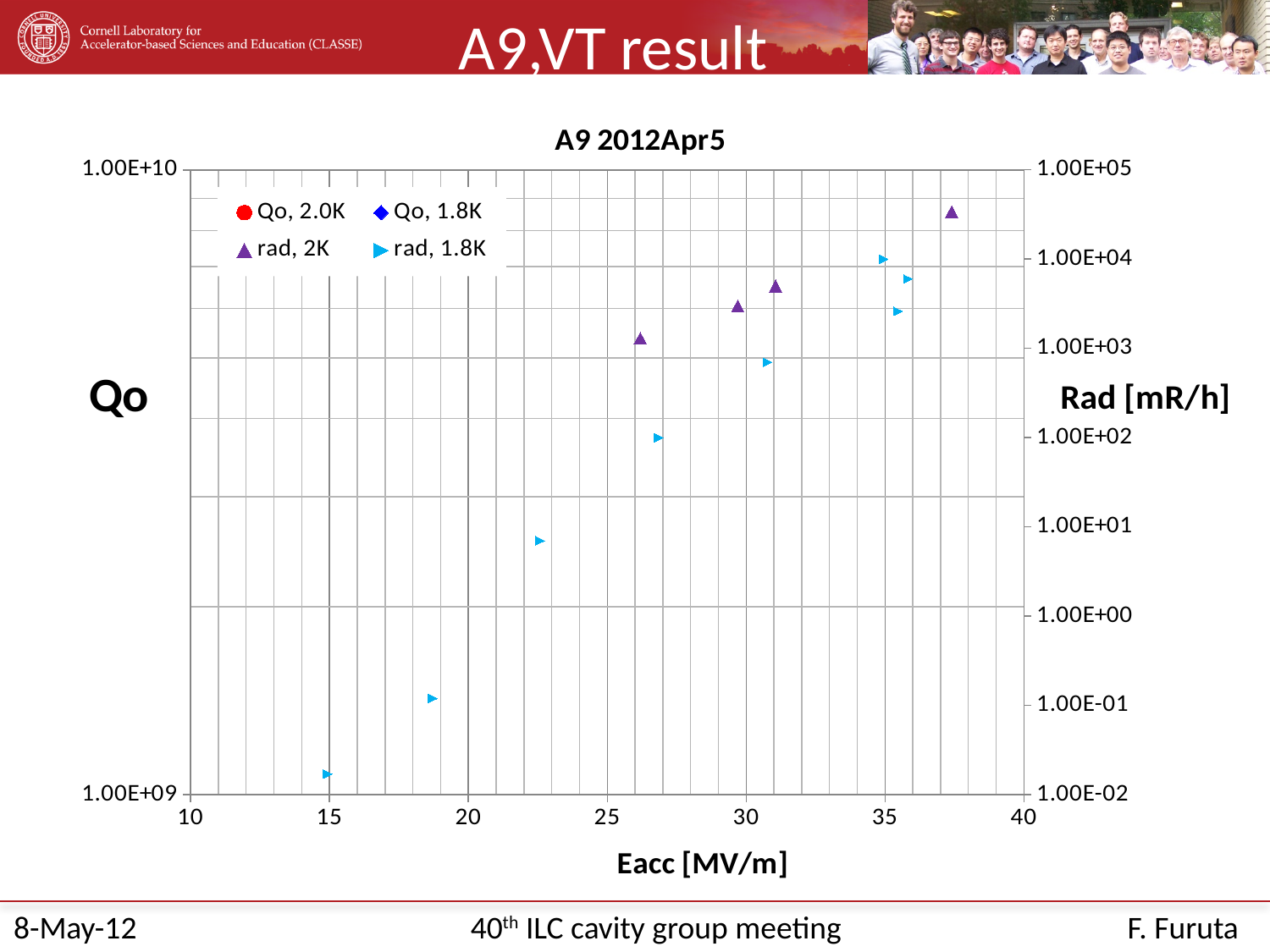
Which series has the highest plotted point on the chart? rad, 2K Is the rad, 1.8K value at the lowest Eacc (near 15 MV/m) greater or less than 1.00E-01 mR/h? less What is the label of the x axis? Eacc [MV/m] How many rad, 2K points are plotted on the chart? 4 Is the rad, 2K value at about 26 MV/m greater or less than 1.00E+03 mR/h? greater What is the title of the chart? A9 2012Apr5 How many series does the chart legend list? 4 What kind of chart is shown on the slide? scatter chart Which is larger: the rad, 1.8K value near 35 MV/m or the rad, 1.8K value near 27 MV/m? the value near 35 MV/m Do the rad, 2K values rise or fall as Eacc increases? rise Do the rad, 1.8K values rise or fall as Eacc increases? rise Is the rad, 2K value at the highest Eacc greater or less than 1.00E+04 mR/h? greater